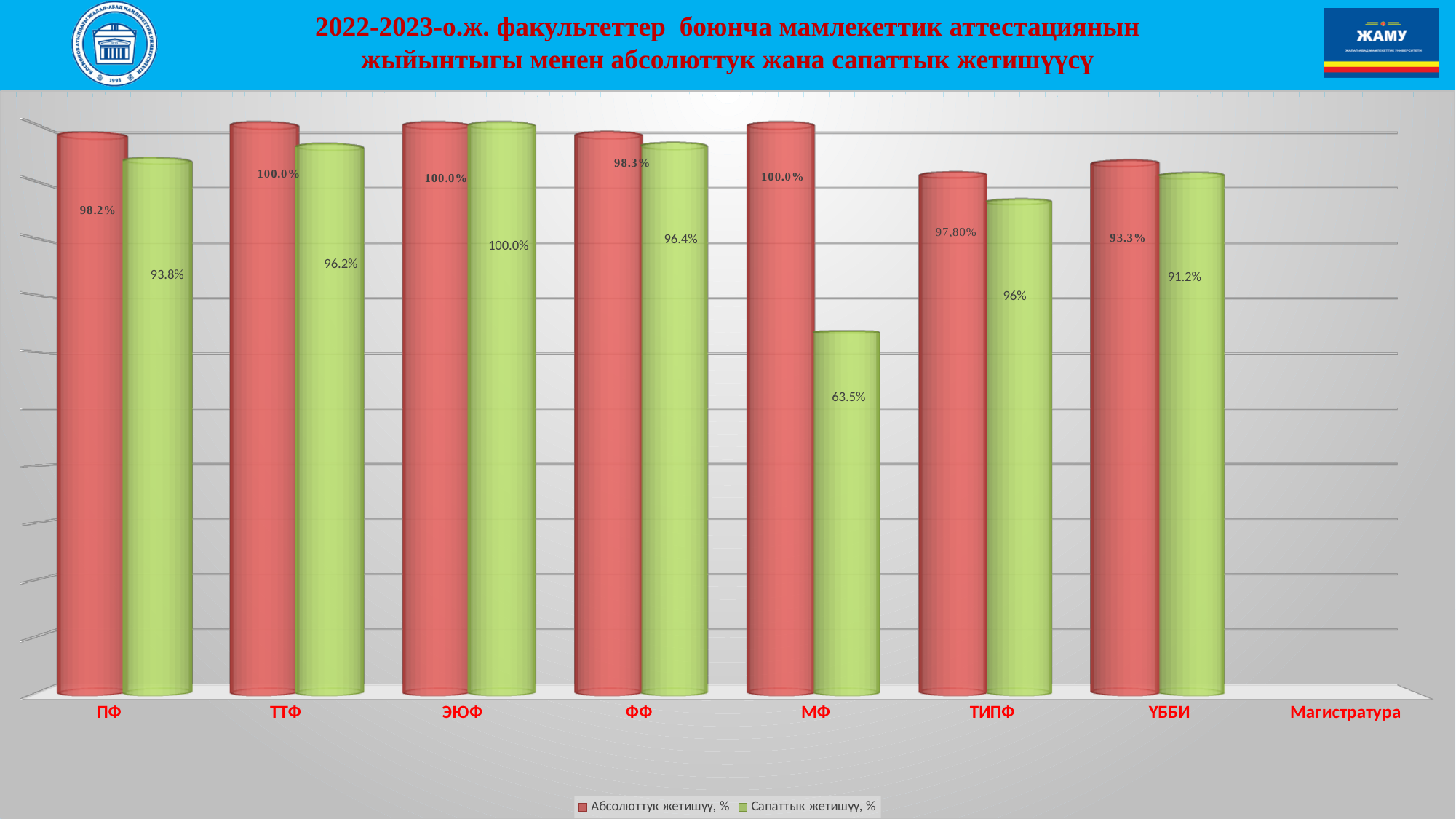
Which faculty has the lowest Сапаттык жетишүү, % value? МФ What is the difference between Абсолюттук жетишүү, % and Сапаттык жетишүү, % for МФ? 36.5 percentage points Which is larger: Сапаттык жетишүү, % for ПФ or for ҮББИ? ПФ What is the value of Абсолюттук жетишүү, % for ПФ? 98.2% What is the value of Абсолюттук жетишүү, % for ТИПФ? 97,80% What kind of chart is shown on the slide? Bar chart What is the value of Сапаттык жетишүү, % for ҮББИ? 91.2% How many categories are shown on the x axis? 8 What is the value of Сапаттык жетишүү, % for МФ? 63.5% How many series does the legend list? 2 Which faculty has the highest Сапаттык жетишүү, % value? ЭЮФ